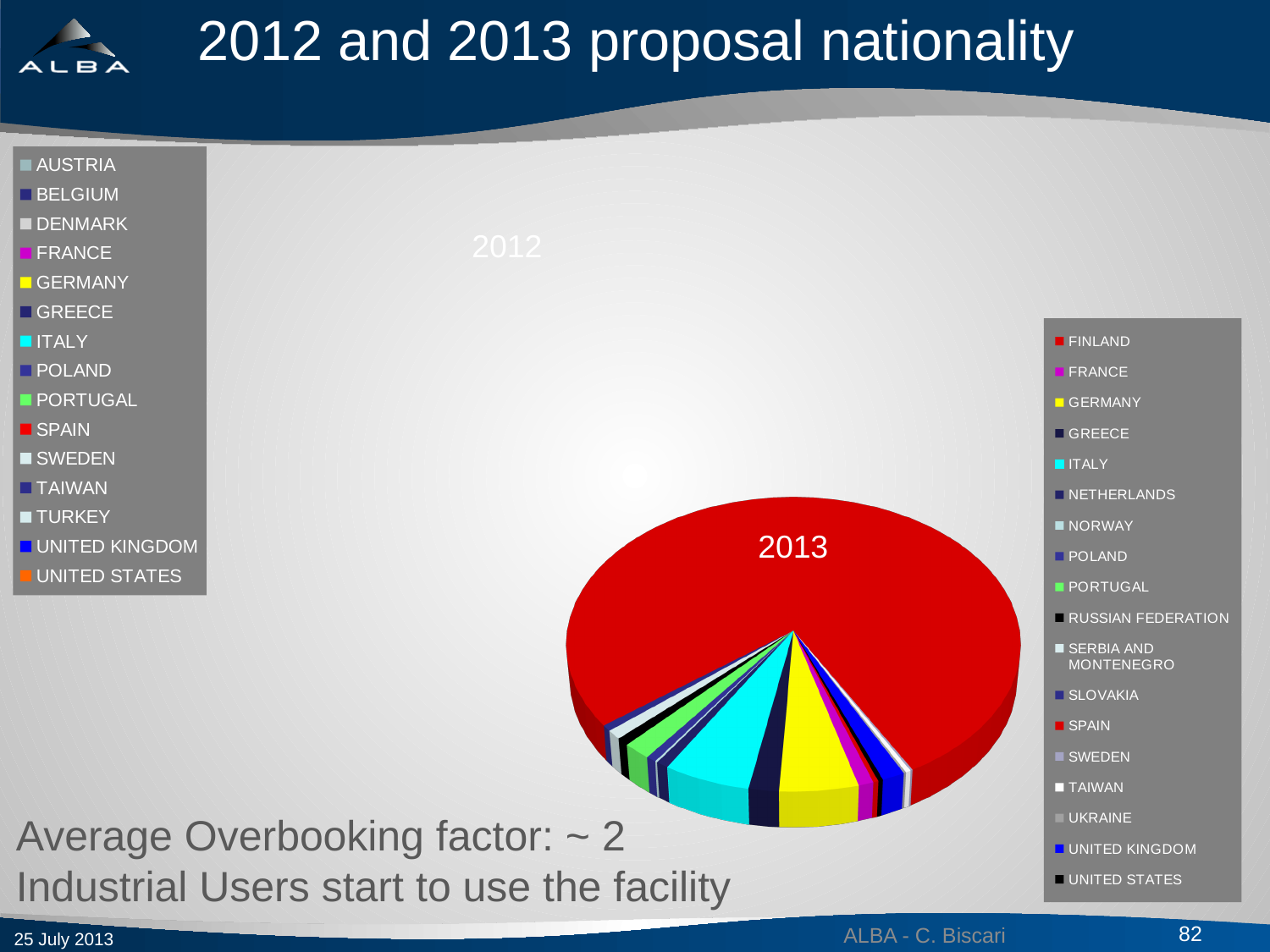
In the 2013 chart, which country has the largest slice? SPAIN What kind of chart is the 2013 chart? pie chart How many countries are listed in the legend of the 2013 chart? 18 In the 2013 chart, which slice is larger, SPAIN or GERMANY? SPAIN What colour represents SPAIN in the 2013 chart legend? red In the 2013 chart, does SPAIN account for more or less than half of the pie? more Which legend entry of the 2013 chart is written on two lines? SERBIA AND MONTENEGRO How many countries are listed in the legend of the 2012 chart? 15 In the 2013 chart, which slice is larger, ITALY or FRANCE? ITALY In the 2013 chart, which slice is larger, SPAIN or ITALY? SPAIN